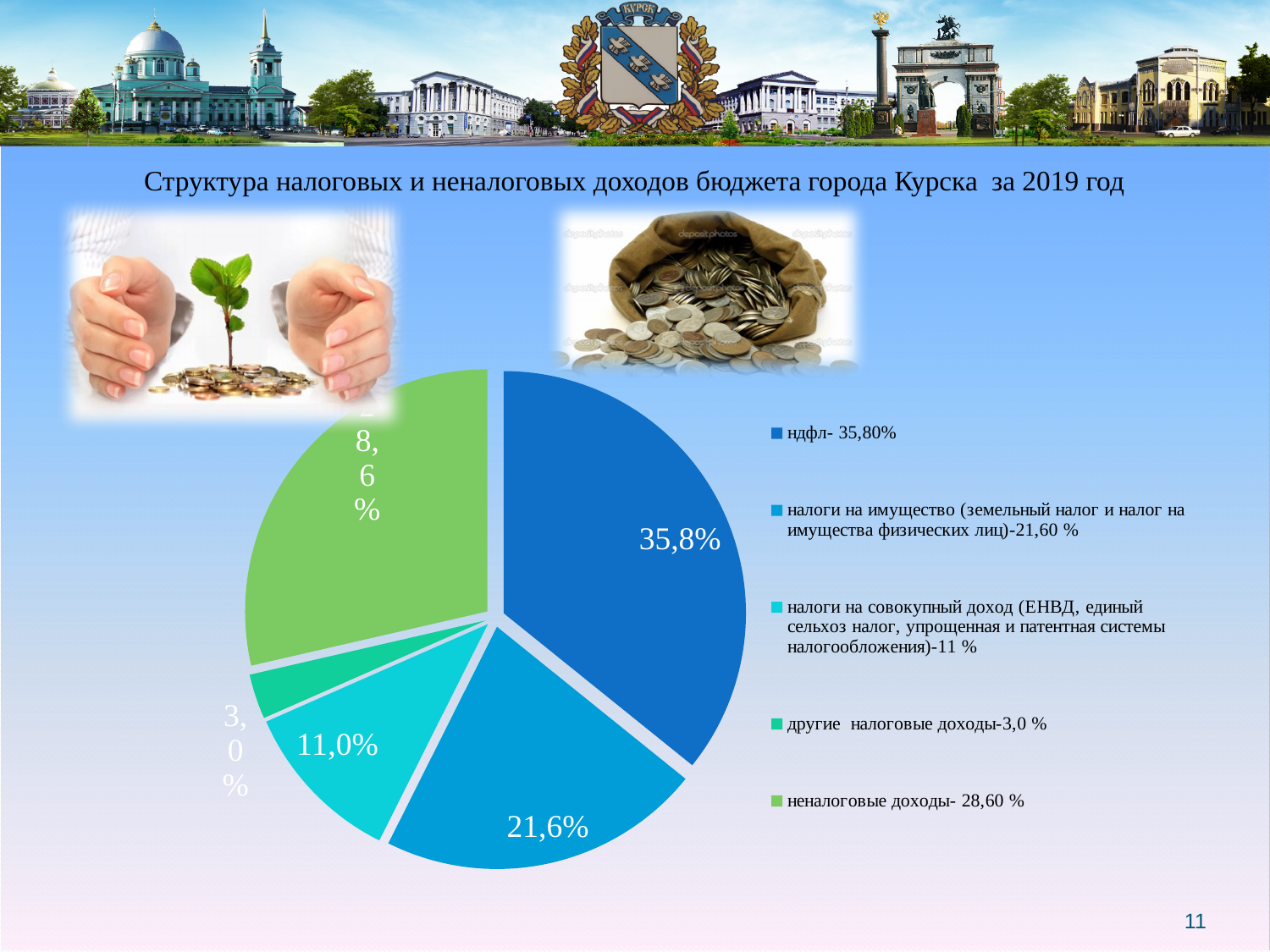
What is the value shown for налоги на имущество (земельный налог и налог на имущества физических лиц)? 21,6% What share of the pie does НДФЛ account for? 35,8% What is the value shown for налоги на совокупный доход (ЕНВД, единый сельхоз налог, упрощенная и патентная системы налогообложения)? 11,0% Which is larger: the share of налоги на имущество or the share of неналоговые доходы? неналоговые доходы Which category has the smallest share of the pie? другие налоговые доходы What type of chart is shown on the slide? pie chart What is the title of the slide containing the chart? Структура налоговых и неналоговых доходов бюджета города Курска за 2019 год According to the legend, what share do неналоговые доходы make up? 28,60 % Which category has the largest share of the pie? НДФЛ How many slices does the pie chart have? 5 What is the difference in percentage points between the НДФЛ share and the налоги на имущество share? 14,2 What is the value shown for другие налоговые доходы? 3,0%